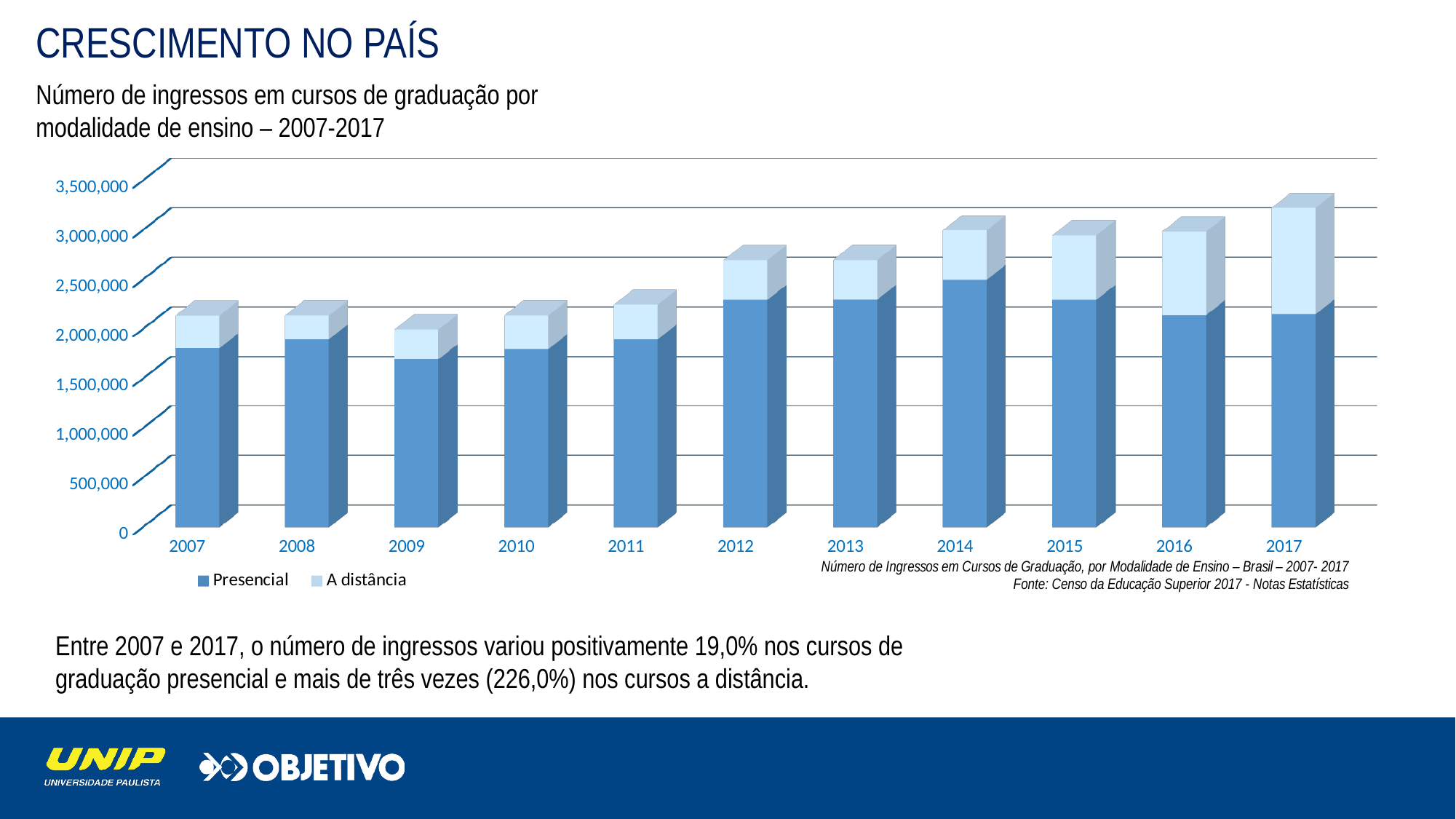
Overall, do the total bars rise or fall from 2007 to 2017? rise Is the total bar for 2009 greater or less than 2,500,000? less How many series does the chart legend list? 2 Which year has the larger total bar, 2007 or 2017? 2017 What are the two series named in the chart legend? Presencial and A distância How many years are shown on the x axis of the chart? 11 Is the Presencial value for 2012 greater or less than 2,000,000? greater Is the total bar for 2017 greater or less than 3,000,000? greater Which year has the highest total number of ingressos in the chart? 2017 Which year has the lowest total number of ingressos in the chart? 2009 What kind of chart is shown on the slide? Stacked bar chart